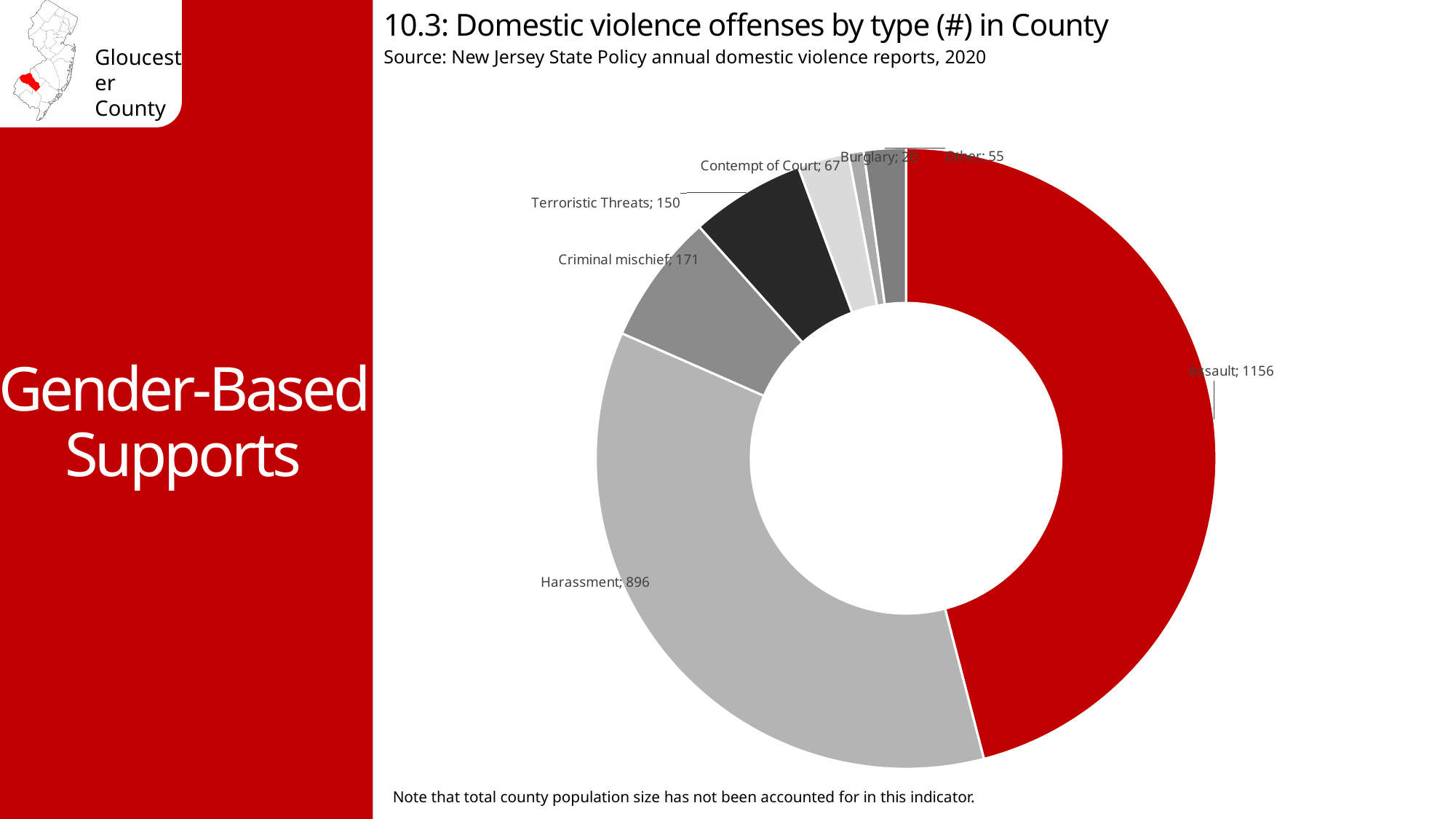
How many offense types are shown in the chart? 7 What is the value for Criminal mischief in the chart? 171 Which offense type has the highest value in the chart? Assault Which is larger, the value for Contempt of Court or the value for Other? Contempt of Court What is the value for Contempt of Court in the chart? 67 What is the value for Terroristic Threats in the chart? 150 What is the value for Harassment in the chart? 896 What is the value for Other in the chart? 55 What is the value for Assault in the chart? 1156 What is the difference between the values for Criminal mischief and Terroristic Threats? 21 What is the difference between the values for Assault and Harassment? 260 What kind of chart is shown on the slide? doughnut chart